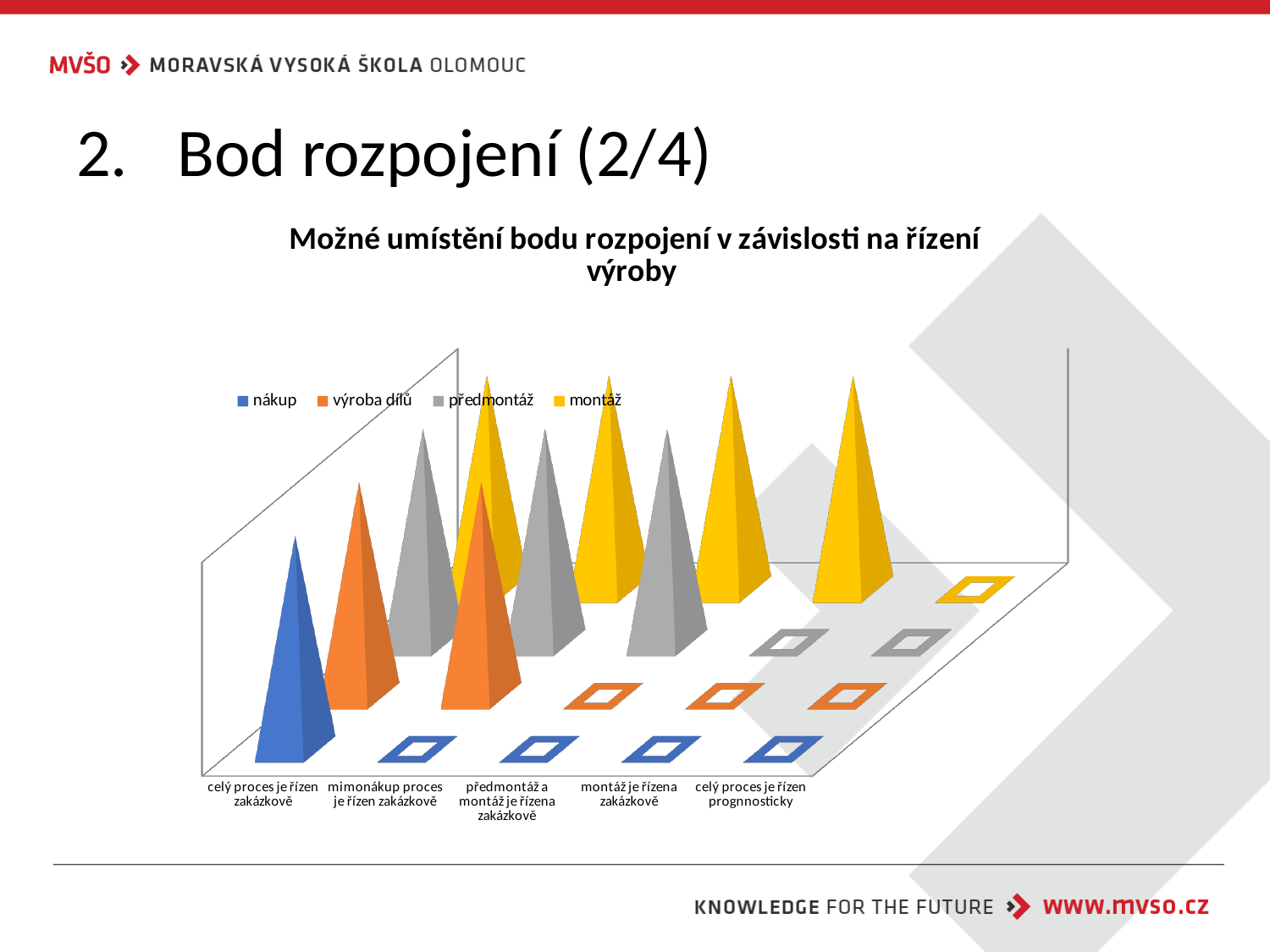
For the category 'montáž je řízena zakázkově', which is larger: the value for montáž or the value for nákup? montáž For the category 'předmontáž a montáž je řízena zakázkově', which is larger: the value for předmontáž or the value for výroba dílů? předmontáž What is the title of the chart? Možné umístění bodu rozpojení v závislosti na řízení výroby How many series does the chart legend list? 4 Which series has a non-zero bar in only one category? nákup How many categories are shown along the x axis of the chart? 5 How many series have a non-zero bar for the category 'předmontáž a montáž je řízena zakázkově'? 2 Does the number of series with non-zero bars rise or fall moving from left to right along the x axis? fall Which series is shown in yellow in the chart legend? montáž What kind of chart is shown on the slide? 3D bar chart (pyramid-shaped bars) For the category 'mimonákup proces je řízen zakázkově', which is larger: the value for výroba dílů or the value for nákup? výroba dílů Which category has a non-zero bar for all four series? celý proces je řízen zakázkově